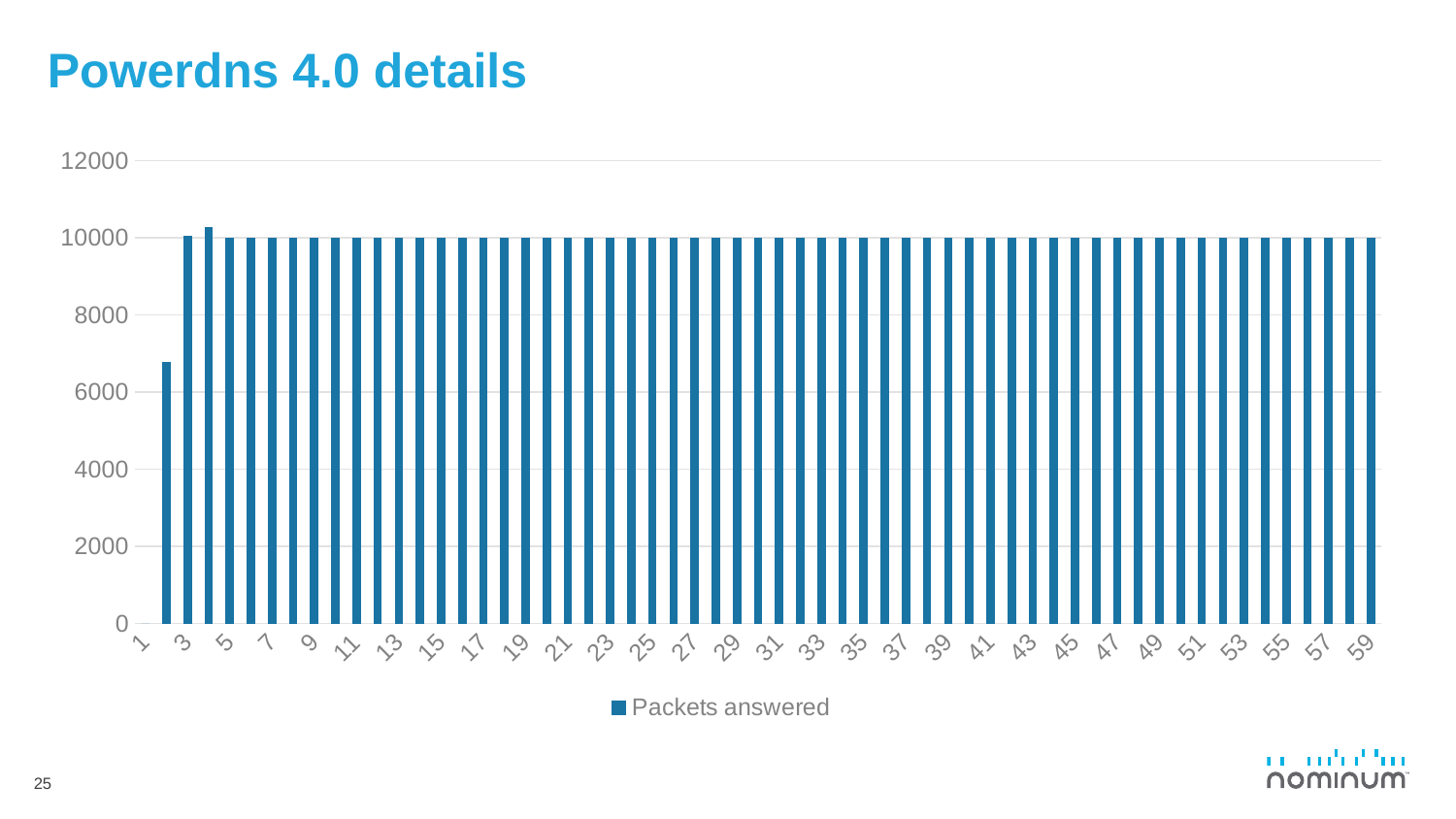
Which is larger, the value for category 4 or the value for category 1? 4 Is the value for category 1 greater or less than 6000? less Which category has the highest value for Packets answered? 4 What is the name of the series shown in the legend? Packets answered How many series does the legend list? 1 Which is larger, the value for category 1 or the value for category 11? 11 From category 5 onward, do the values rise, fall, or stay roughly flat along the x axis? stay roughly flat What is the title of the chart on the slide? Powerdns 4.0 details Is the value for category 1 greater or less than 8000? less What kind of chart is shown on the slide? bar chart Is the value for category 21 greater or less than 8000? greater Which category has the lowest value for Packets answered? 1